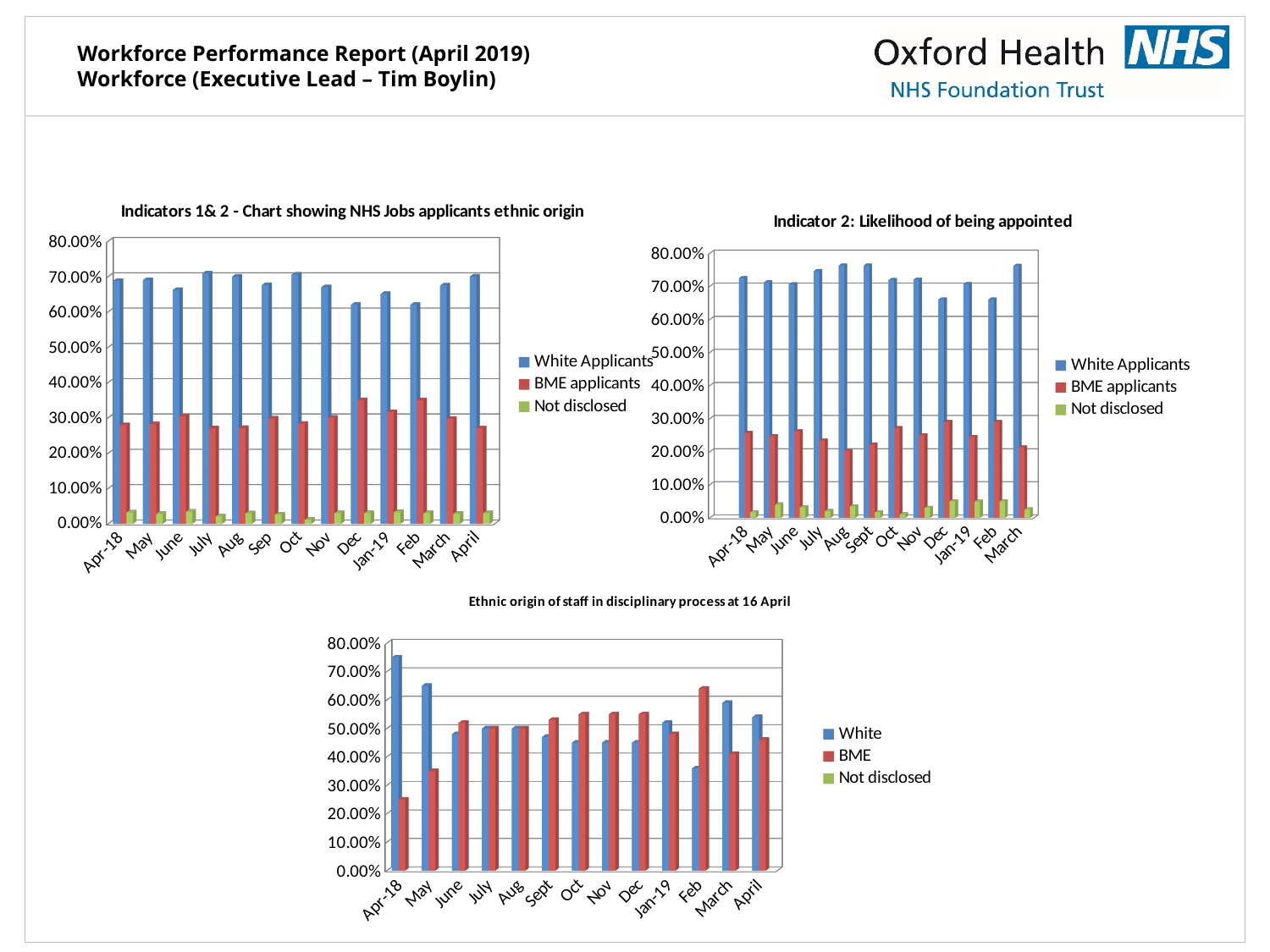
What kind of chart is the chart titled 'Ethnic origin of staff in disciplinary process at 16 April'? Bar chart In the chart titled 'Indicator 2: Likelihood of being appointed', is the value for White Applicants in Dec greater or less than 70.00%? less In the chart titled 'Ethnic origin of staff in disciplinary process at 16 April', in Feb, which is larger: White or BME? BME In the chart titled 'Ethnic origin of staff in disciplinary process at 16 April', is the value for White in Apr-18 greater or less than 70.00%? greater In the chart titled 'Ethnic origin of staff in disciplinary process at 16 April', which month has the highest value for White? Apr-18 In the chart titled 'Indicators 1& 2 - Chart showing NHS Jobs applicants ethnic origin', in Apr-18, which is larger: White Applicants or BME applicants? White Applicants In the chart titled 'Ethnic origin of staff in disciplinary process at 16 April', which month has the lowest value for BME? Apr-18 In the chart titled 'Indicator 2: Likelihood of being appointed', how many months are shown on the x axis? 12 In the chart titled 'Indicators 1& 2 - Chart showing NHS Jobs applicants ethnic origin', how many series does the legend list? 3 In the chart titled 'Indicators 1& 2 - Chart showing NHS Jobs applicants ethnic origin', is the value for BME applicants in Dec greater or less than 30.00%? greater In the chart titled 'Ethnic origin of staff in disciplinary process at 16 April', which month has the lowest value for White? Feb In the chart titled 'Ethnic origin of staff in disciplinary process at 16 April', which month has the highest value for BME? Feb